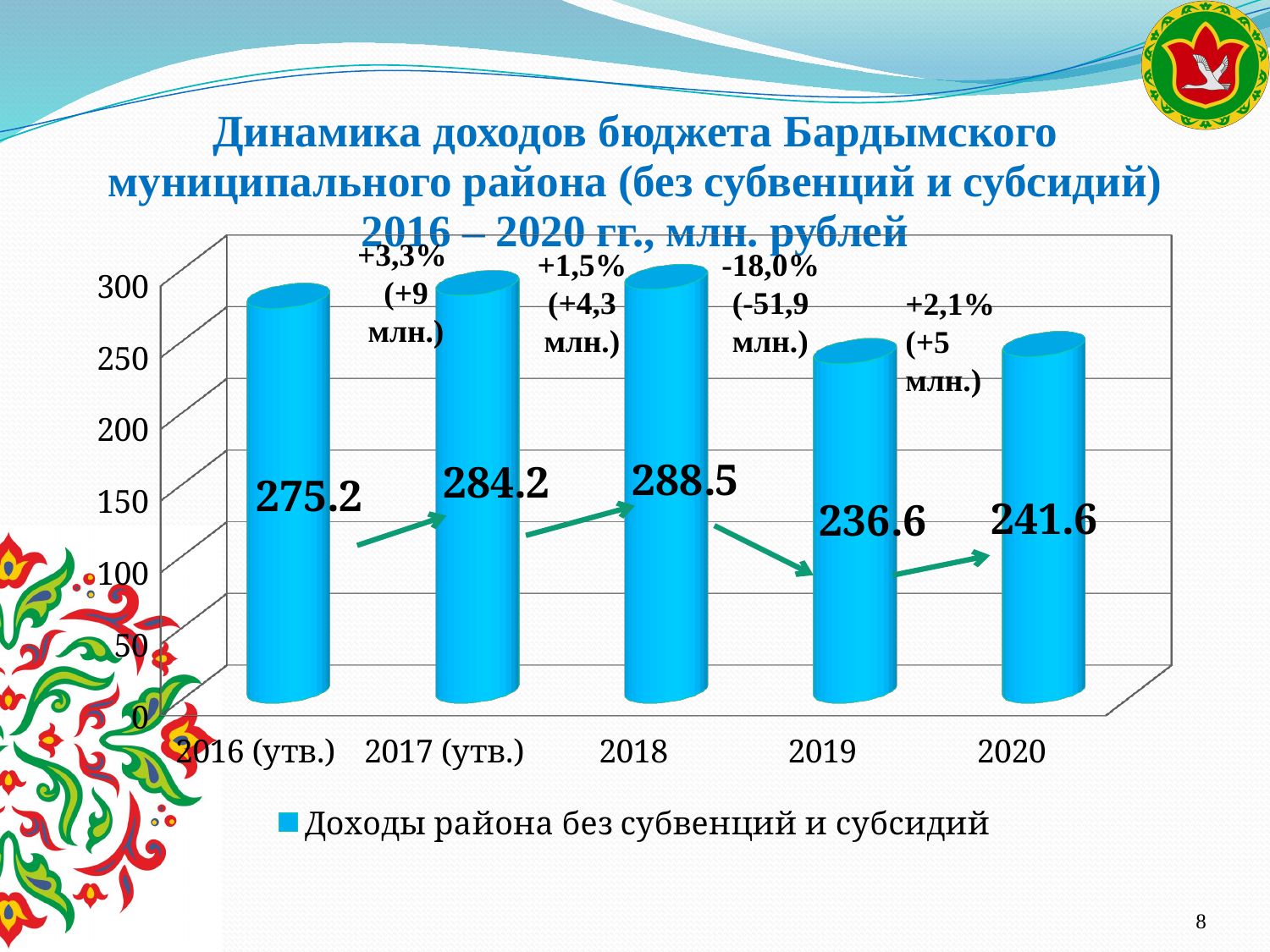
What is the value for 2016 (утв.)? 275.2 What is the legend entry for the series shown? Доходы района без субвенций и субсидий Which year has the highest value? 2018 How many years are shown on the x axis? 5 What is the value for 2019? 236.6 Is the value for 2019 greater or less than 250? less What is the difference between the values for 2018 and 2019? 51.9 What kind of chart is shown on the slide? bar chart Which year has the lowest value? 2019 What is the difference between the values for 2017 (утв.) and 2016 (утв.)? 9 Which is larger, the value for 2020 or the value for 2019? 2020 What is the value for 2018? 288.5